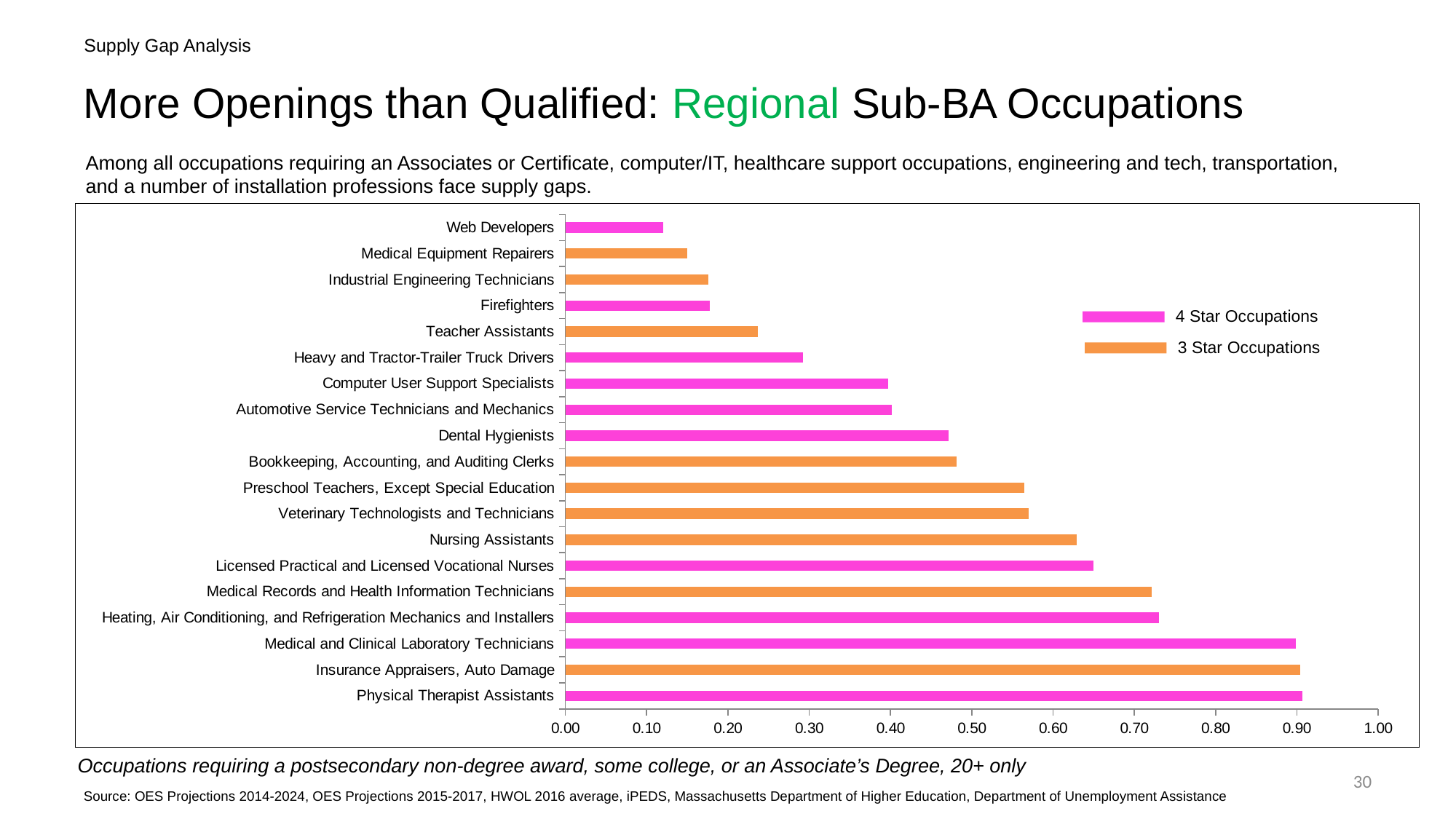
Is the value for Firefighters greater or less than 0.20? less Is the value for Medical Records and Health Information Technicians greater or less than 0.70? greater Is the value for Teacher Assistants greater or less than 0.20? greater Which occupation has the lowest value in the chart? Web Developers Which legend entry is shown in orange? 3 Star Occupations Which has the larger value, Nursing Assistants or Teacher Assistants? Nursing Assistants How many occupations are plotted in the chart? 19 How many series does the legend list? 2 Which series is Physical Therapist Assistants plotted in? 4 Star Occupations What kind of chart is shown on the slide? bar chart